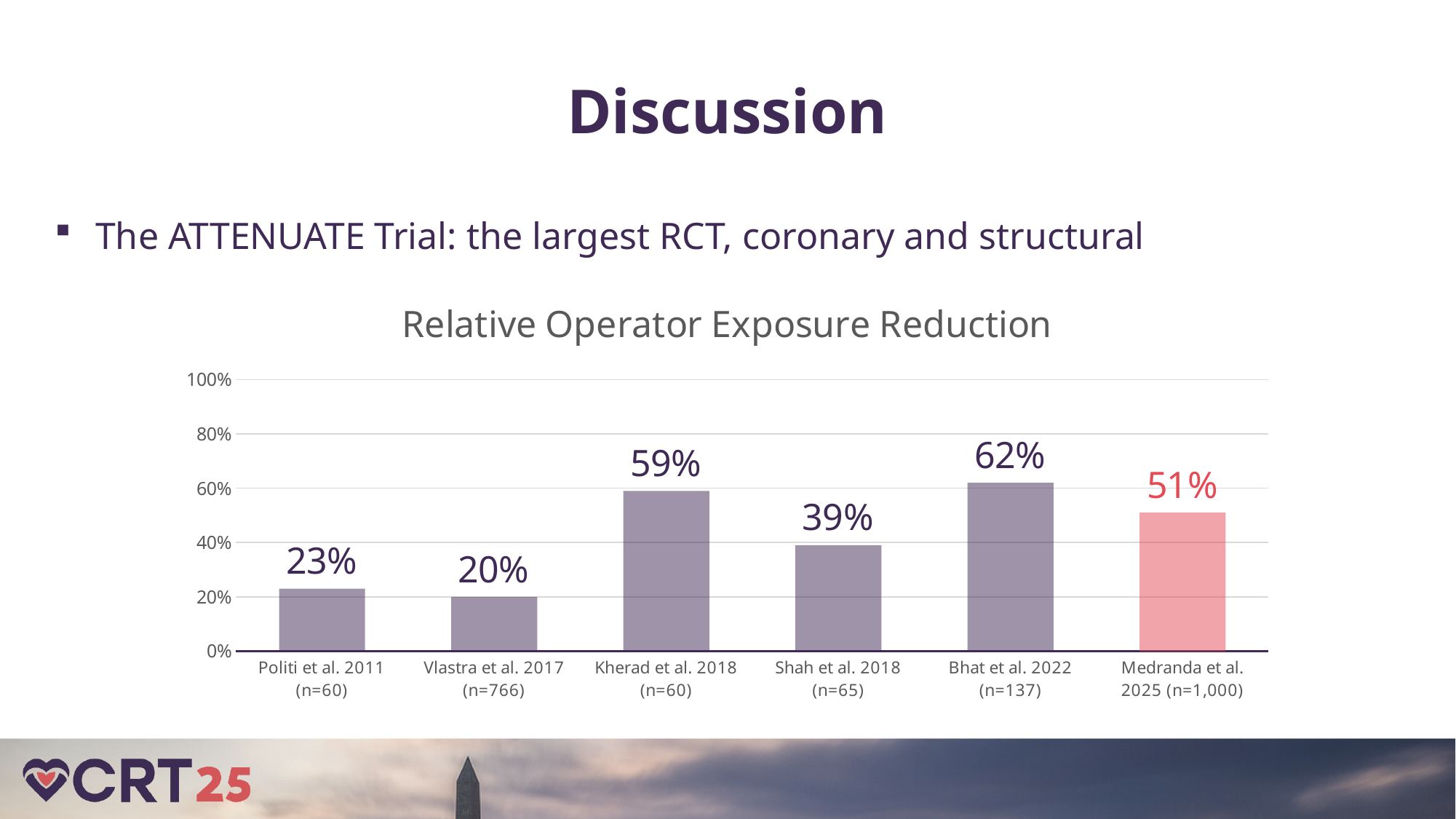
What is the title of the chart? Relative Operator Exposure Reduction Which is larger, the value for Politi et al. 2011 or the value for Shah et al. 2018? Shah et al. 2018 What is the difference between the values for Bhat et al. 2022 and Medranda et al. 2025? 11% What is the relative operator exposure reduction for Kherad et al. 2018 (n=60)? 59% What is the value shown for Vlastra et al. 2017 (n=766)? 20% What kind of chart is shown on the slide? Bar chart Is the value for Medranda et al. 2025 greater or less than 40%? greater What is the difference between the values for Kherad et al. 2018 and Shah et al. 2018? 20% How many studies are shown on the chart? 6 Which study has the highest relative operator exposure reduction? Bhat et al. 2022 (n=137) Which study has the lowest relative operator exposure reduction? Vlastra et al. 2017 (n=766) What is the relative operator exposure reduction for Medranda et al. 2025 (n=1,000)? 51%